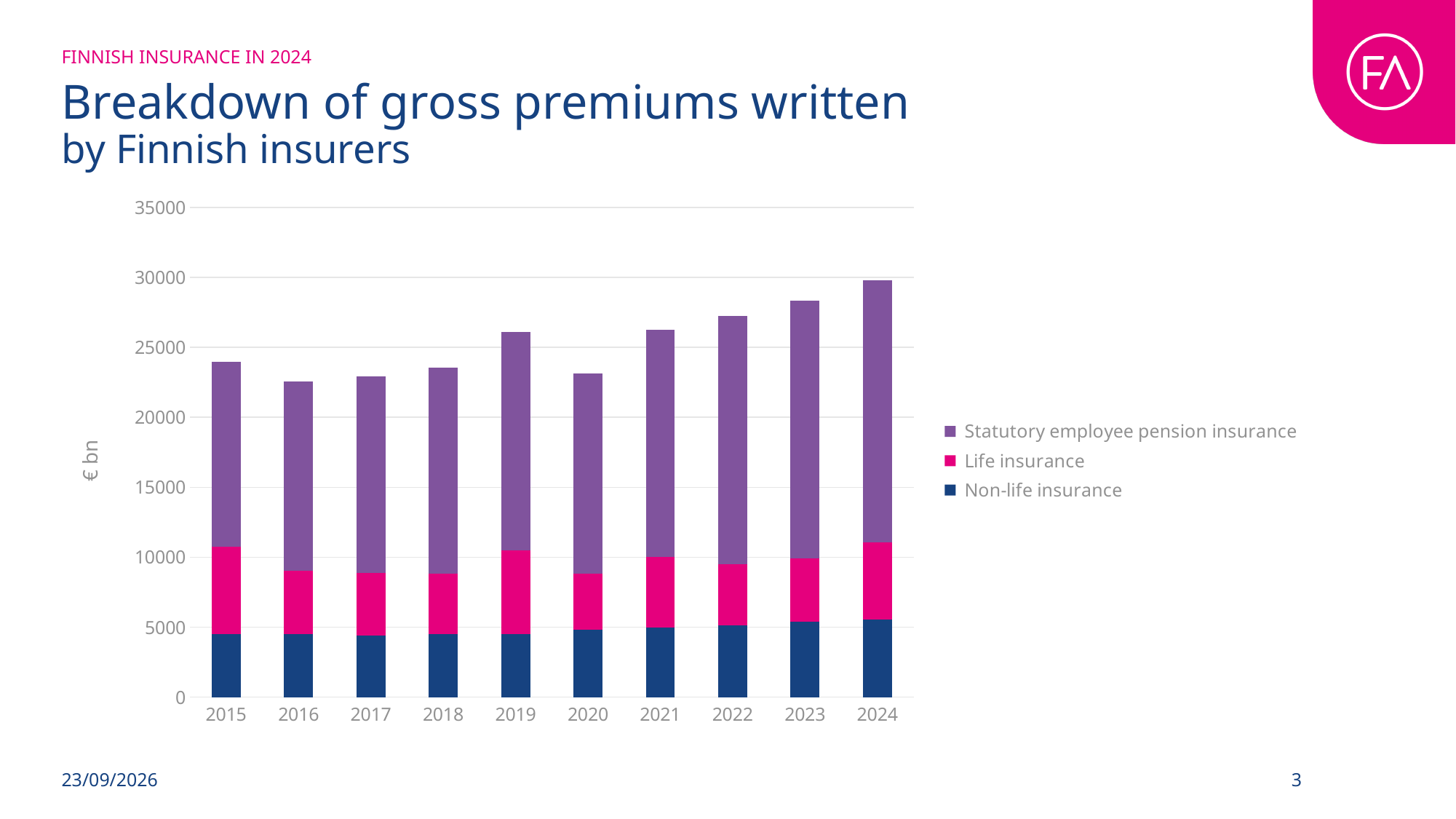
How many years are shown on the x axis of the chart? 10 Which year has the larger total, 2023 or 2018? 2023 Is the total for 2024 greater or less than 25000? greater Which year has the larger total, 2019 or 2020? 2019 Do the total gross premiums written rise or fall from 2020 to 2024? Rise Which series is shown at the bottom of each stacked bar? Non-life insurance Which year has the highest total gross premiums written? 2024 Is the total for 2016 greater or less than 25000? less What is the label on the y axis of the chart? € bn How many series does the chart's legend list? 3 What kind of chart is shown on the slide? Stacked bar chart Is the total for 2015 greater or less than 25000? less